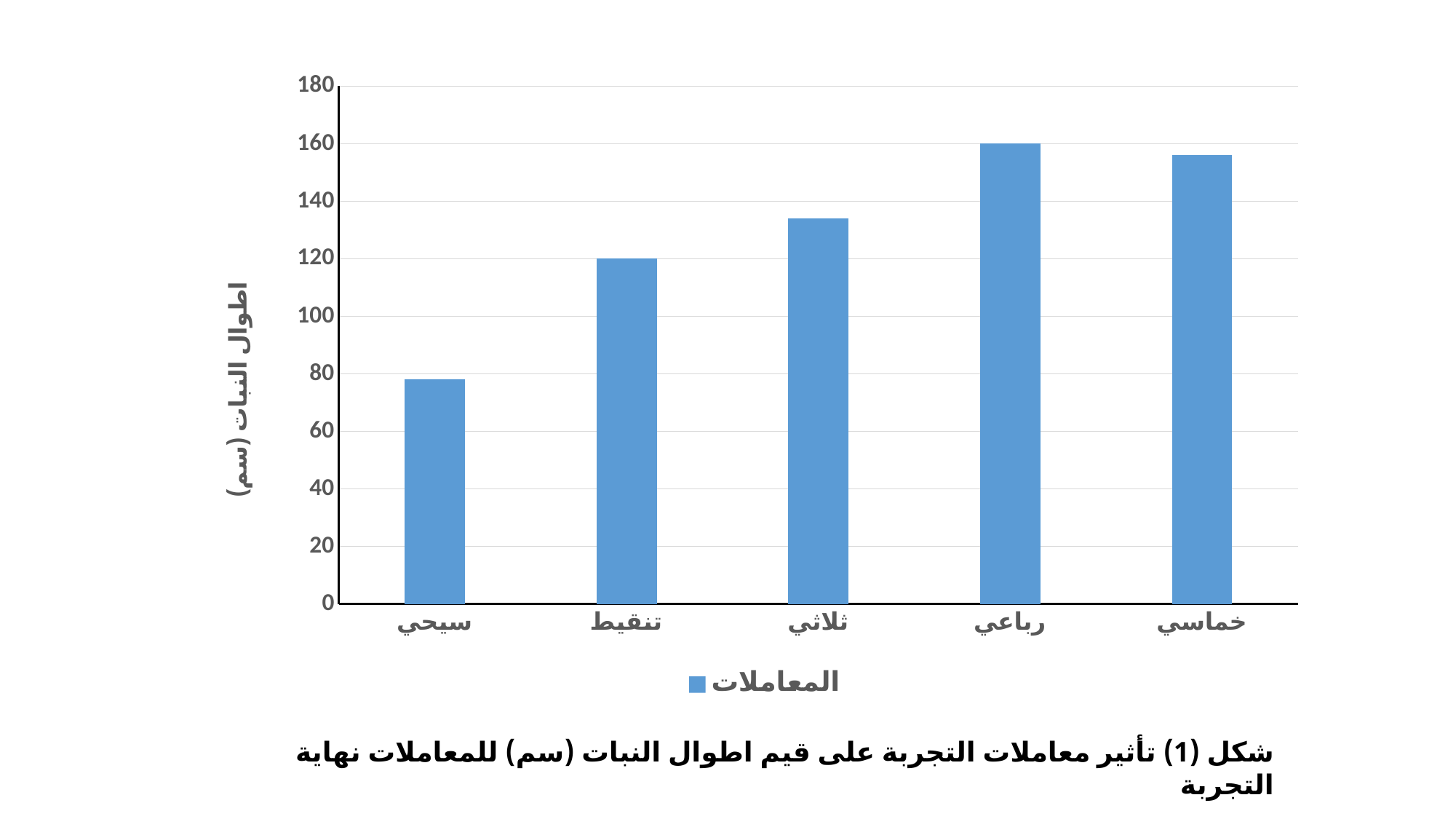
How many series does the legend list? 1 What is the difference between the values for رباعي and تنقيط? 40 How many categories are shown on the x axis of the chart? 5 Which is larger, the value for سيحي or the value for تنقيط? تنقيط Which category has the lowest value? سيحي What is the value for رباعي? 160 What type of chart is shown on the slide? bar chart Is the value for ثلاثي greater or less than 120? greater What is the legend entry for the series in the chart? المعاملات What is the value for تنقيط? 120 Is the value for خماسي greater or less than 140? greater